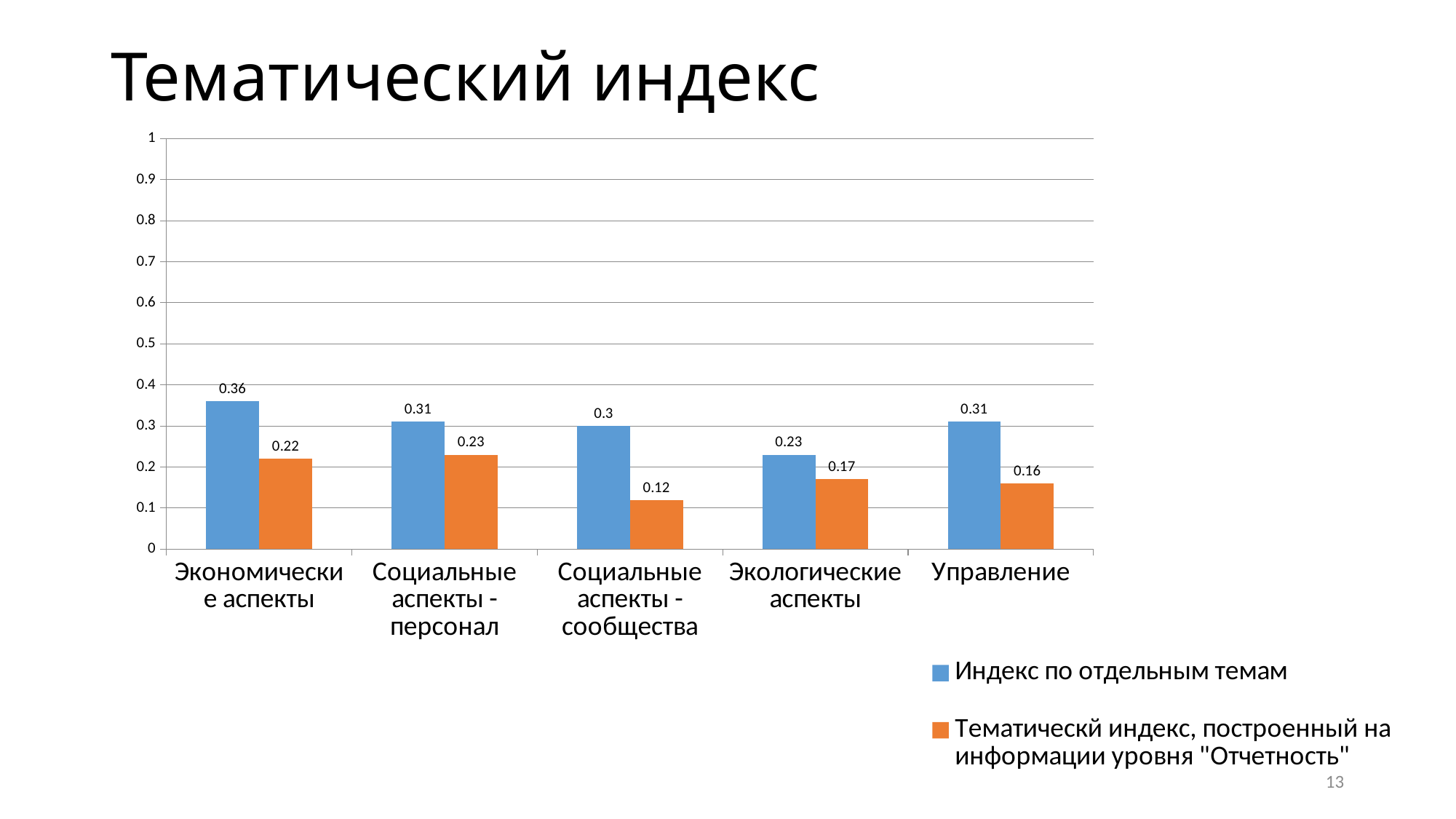
Which category has the highest value for "Индекс по отдельным темам"? Экономические аспекты Which category has the lowest value for "Тематическй индекс, построенный на информации уровня "Отчетность""? Социальные аспекты - сообщества What is the value of "Тематическй индекс, построенный на информации уровня "Отчетность"" for "Социальные аспекты - сообщества"? 0.12 What kind of chart is shown on the slide? bar chart What is the difference between the two series for "Социальные аспекты - сообщества"? 0.18 What is the value of "Индекс по отдельным темам" for "Управление"? 0.31 What is the title of the slide? Тематический индекс What is the value of "Индекс по отдельным темам" for "Экономические аспекты"? 0.36 How many series does the legend list? 2 Is the value of "Индекс по отдельным темам" for "Социальные аспекты - персонал" greater or less than 0.4? less How many categories are shown on the x axis? 5 For "Экологические аспекты", which series has the larger value? Индекс по отдельным темам